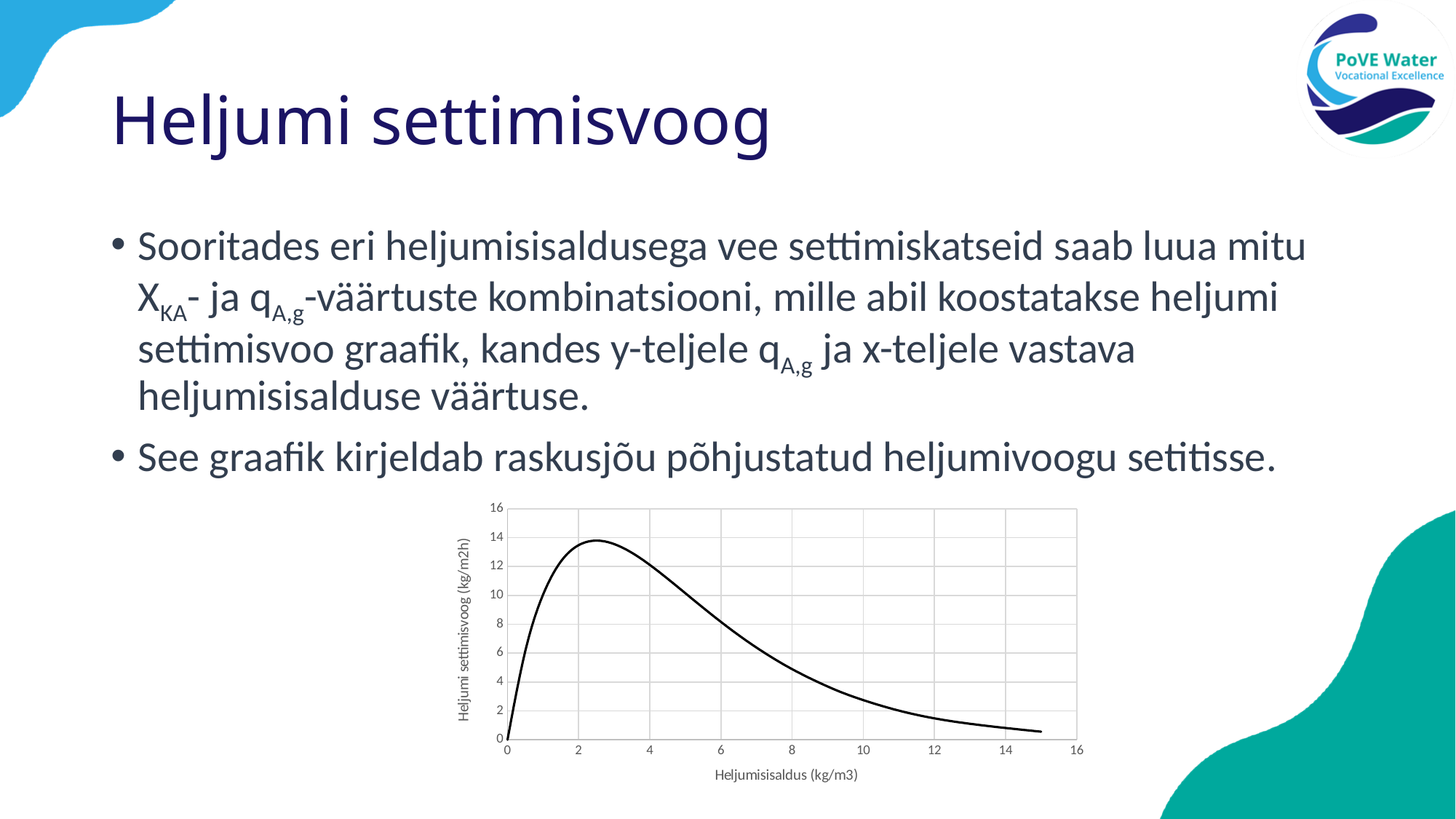
Is the value of the curve at Heljumisisaldus 14 kg/m3 greater or less than 2? less Is the peak value of the curve greater or less than 12? greater What kind of chart is shown on the slide? line chart Is the value of the curve at Heljumisisaldus 6 kg/m3 greater or less than 6? greater Does the curve rise or fall as Heljumisisaldus increases from 0 to 2 kg/m3? rise Is the value of the curve at Heljumisisaldus 2 kg/m3 larger or smaller than at 10 kg/m3? larger What is the label of the y axis of the chart? Heljumi settimisvoog (kg/m2h) Does the curve rise or fall as Heljumisisaldus increases from 4 to 14 kg/m3? fall What is the label of the x axis of the chart? Heljumisisaldus (kg/m3) What is the highest tick value shown on the y axis? 16